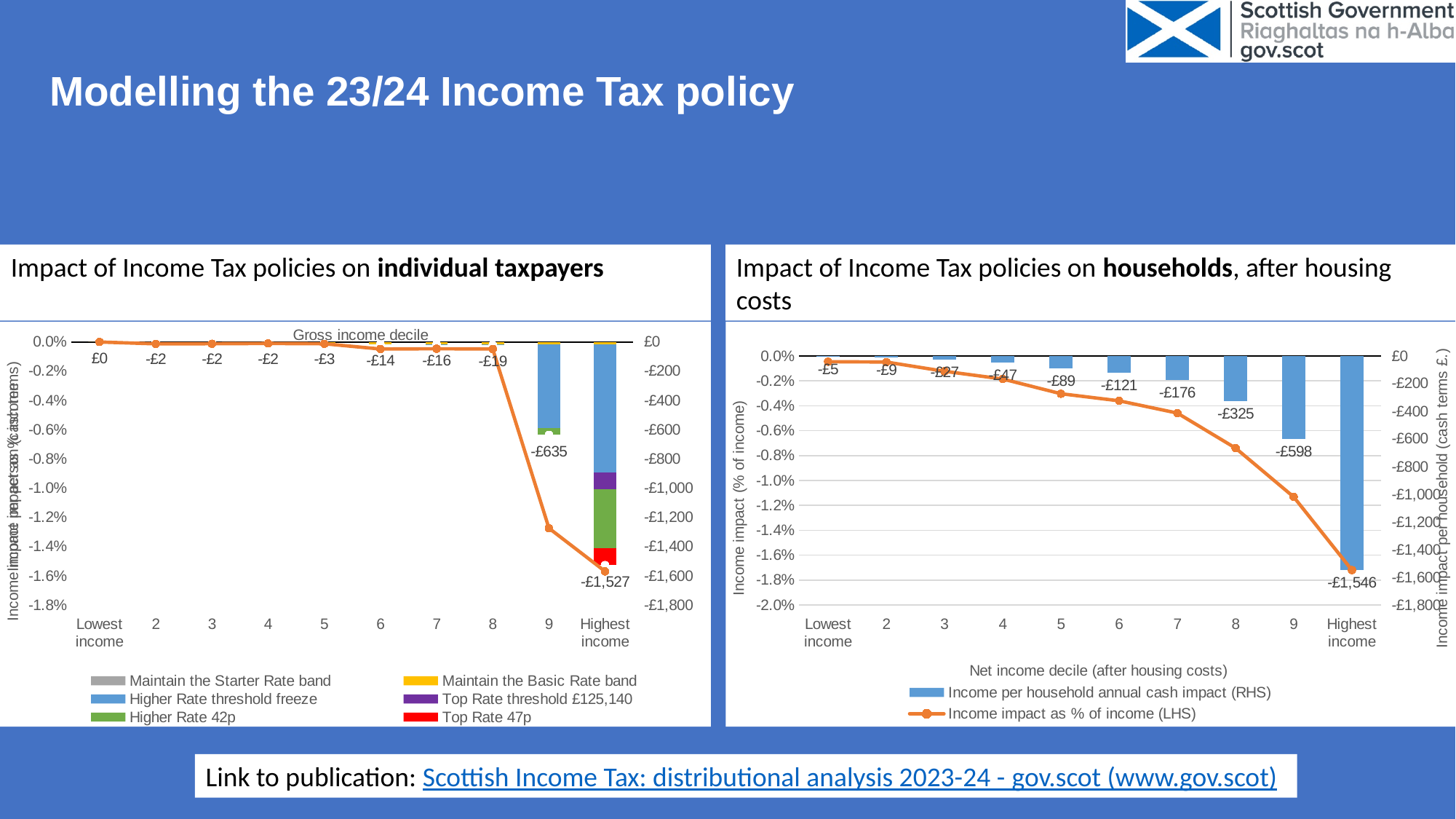
In the 'Impact of Income Tax policies on households, after housing costs' chart, which decile has the largest cash impact (most negative)? Highest income In the 'Impact of Income Tax policies on households, after housing costs' chart, does the income impact as % of income line rise or fall from the lowest to the highest income decile? Fall In the 'Impact of Income Tax policies on households, after housing costs' chart, what is the income per household annual cash impact for the highest income decile? -£1,546 In the 'Impact of Income Tax policies on individual taxpayers' chart, how many entries does the legend list? 6 In the 'Impact of Income Tax policies on individual taxpayers' chart, what is the cash impact labelled for the lowest income decile? £0 In the 'Impact of Income Tax policies on households, after housing costs' chart, what is the difference between the cash impact for decile 9 and decile 8? £273 In the 'Impact of Income Tax policies on households, after housing costs' chart, how many series does the legend list? 2 In the 'Impact of Income Tax policies on individual taxpayers' chart, what is the cash impact labelled for decile 9? -£635 In the 'Impact of Income Tax policies on households, after housing costs' chart, how many income deciles are shown on the x axis? 10 In the 'Impact of Income Tax policies on individual taxpayers' chart, which legend entry is shown in red? Top Rate 47p In the 'Impact of Income Tax policies on households, after housing costs' chart, what is the cash impact labelled for decile 8? -£325 In the 'Impact of Income Tax policies on individual taxpayers' chart, what is the cash impact labelled for the highest income decile? -£1,527